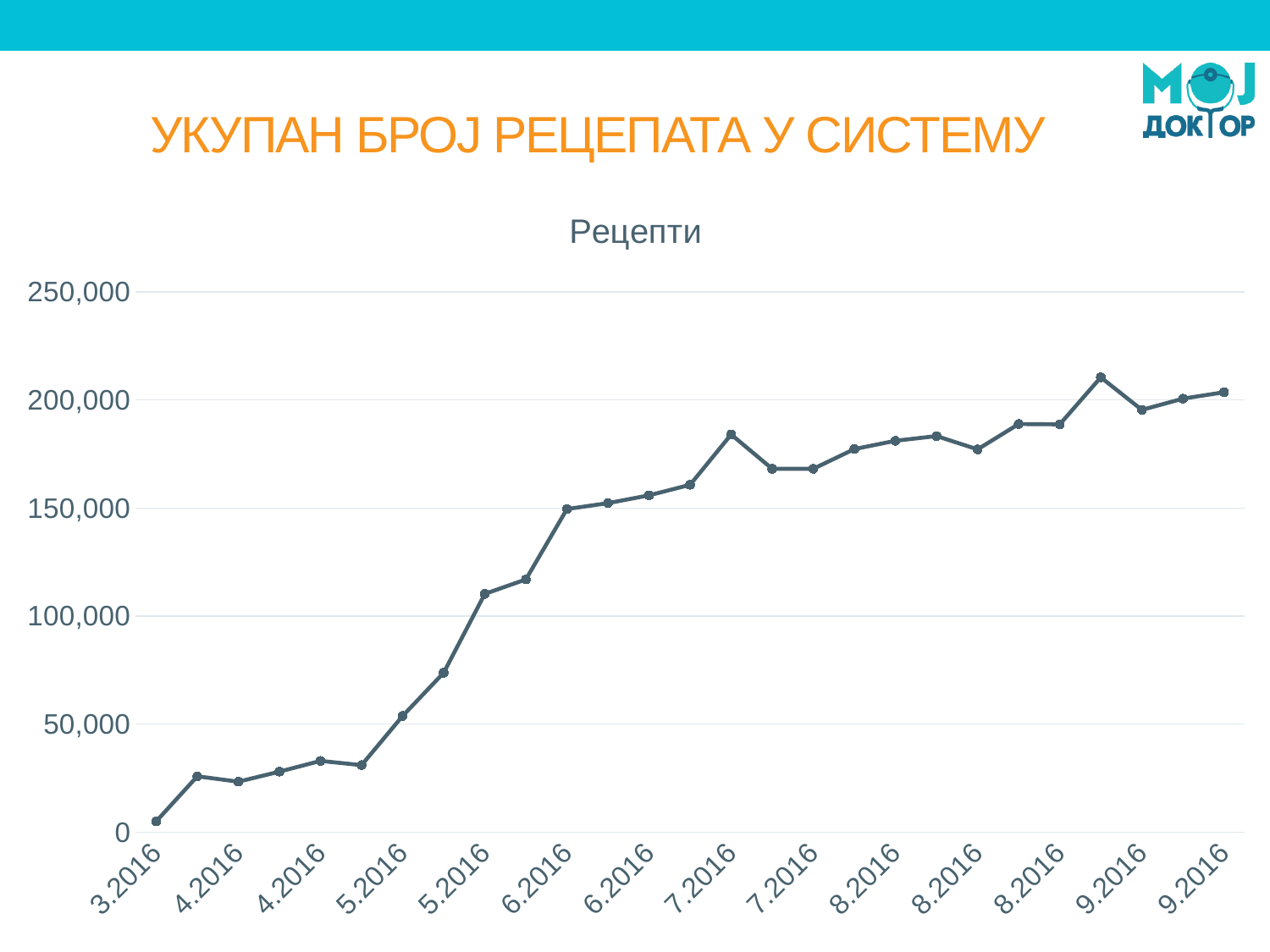
Which is larger, the value for 3.2016 or the value for the last 9.2016 point? the last 9.2016 point What is the title of the chart? Рецепти Is the value for the first 7.2016 point greater or less than 150,000? greater Is the value for 3.2016 greater or less than 50,000? less Which is larger, the value for the first 4.2016 point or the value for the first 7.2016 point? the first 7.2016 point What is the title of the slide? УКУПАН БРОЈ РЕЦЕПАТА У СИСТЕМУ Do the values generally rise or fall from 3.2016 to 9.2016? rise Is the value for the first 8.2016 point greater or less than 200,000? less Which x-axis label has the lowest value on the chart? 3.2016 What kind of chart is shown on the slide? line chart